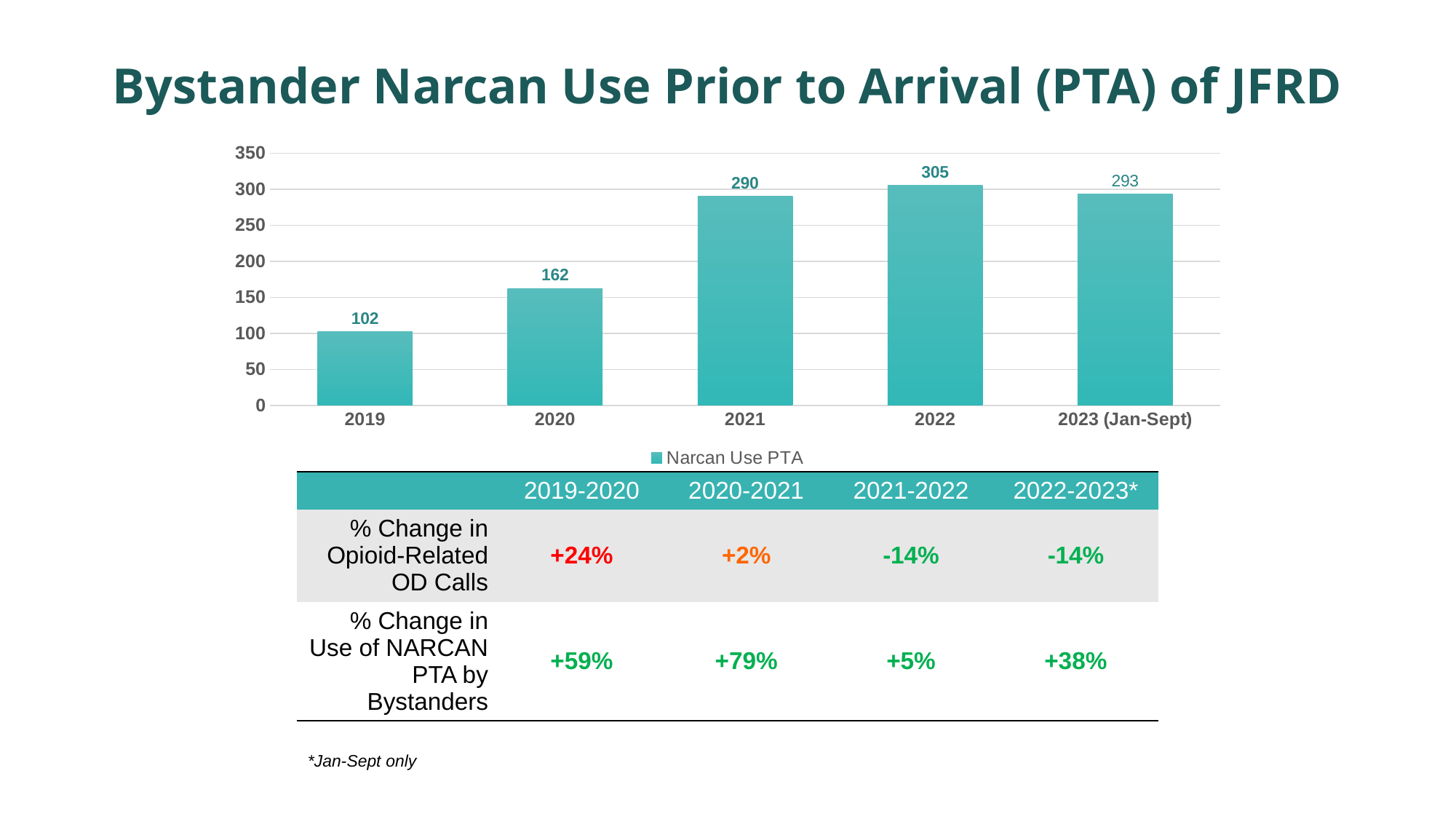
Which year has the lowest Narcan Use PTA value? 2019 What is the Narcan Use PTA value for 2023 (Jan-Sept)? 293 What series name does the chart legend show? Narcan Use PTA What is the difference between the Narcan Use PTA values for 2022 and 2021? 15 What kind of chart is shown on the slide? bar chart What is the difference between the Narcan Use PTA values for 2020 and 2019? 60 What is the Narcan Use PTA value for 2021? 290 How many years are shown on the x axis of the chart? 5 Which year has the highest Narcan Use PTA value? 2022 Which is larger, the Narcan Use PTA value for 2020 or for 2021? 2021 What is the Narcan Use PTA value for 2019? 102 Is the Narcan Use PTA value for 2020 greater or less than 150? greater